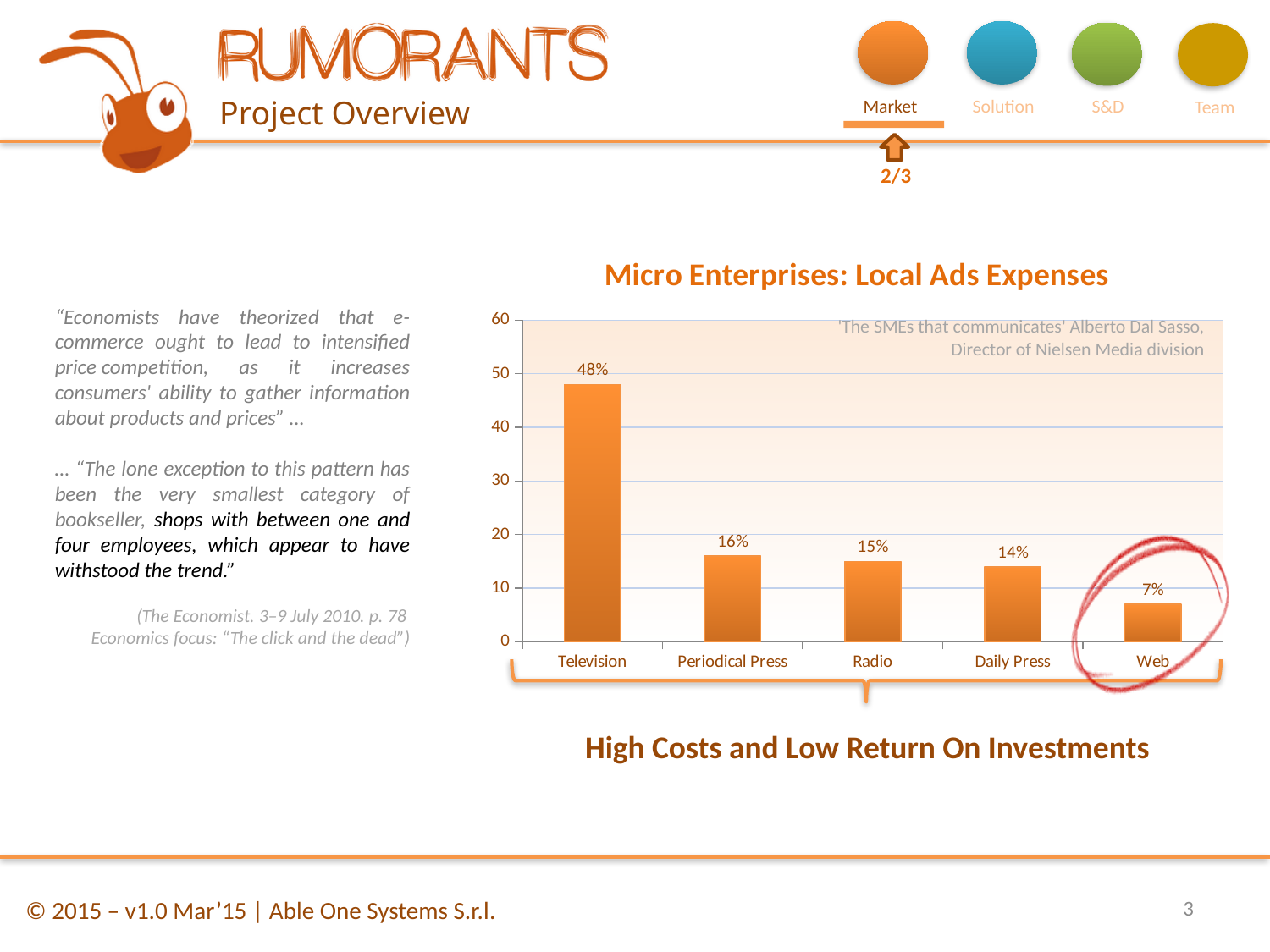
What is the value for Radio? 15% Which category has the lowest value? Web What is the difference between the values for Television and Web? 41% What is the value for Television? 48% Which category has the highest value? Television Is the value for Daily Press greater or less than 20? less How many categories are shown on the x axis? 5 What kind of chart is shown on the slide? bar chart Which is larger, the value for Periodical Press or the value for Web? Periodical Press What is the difference between the values for Periodical Press and Daily Press? 2% What is the value for Web? 7% What is the title of the chart? Micro Enterprises: Local Ads Expenses